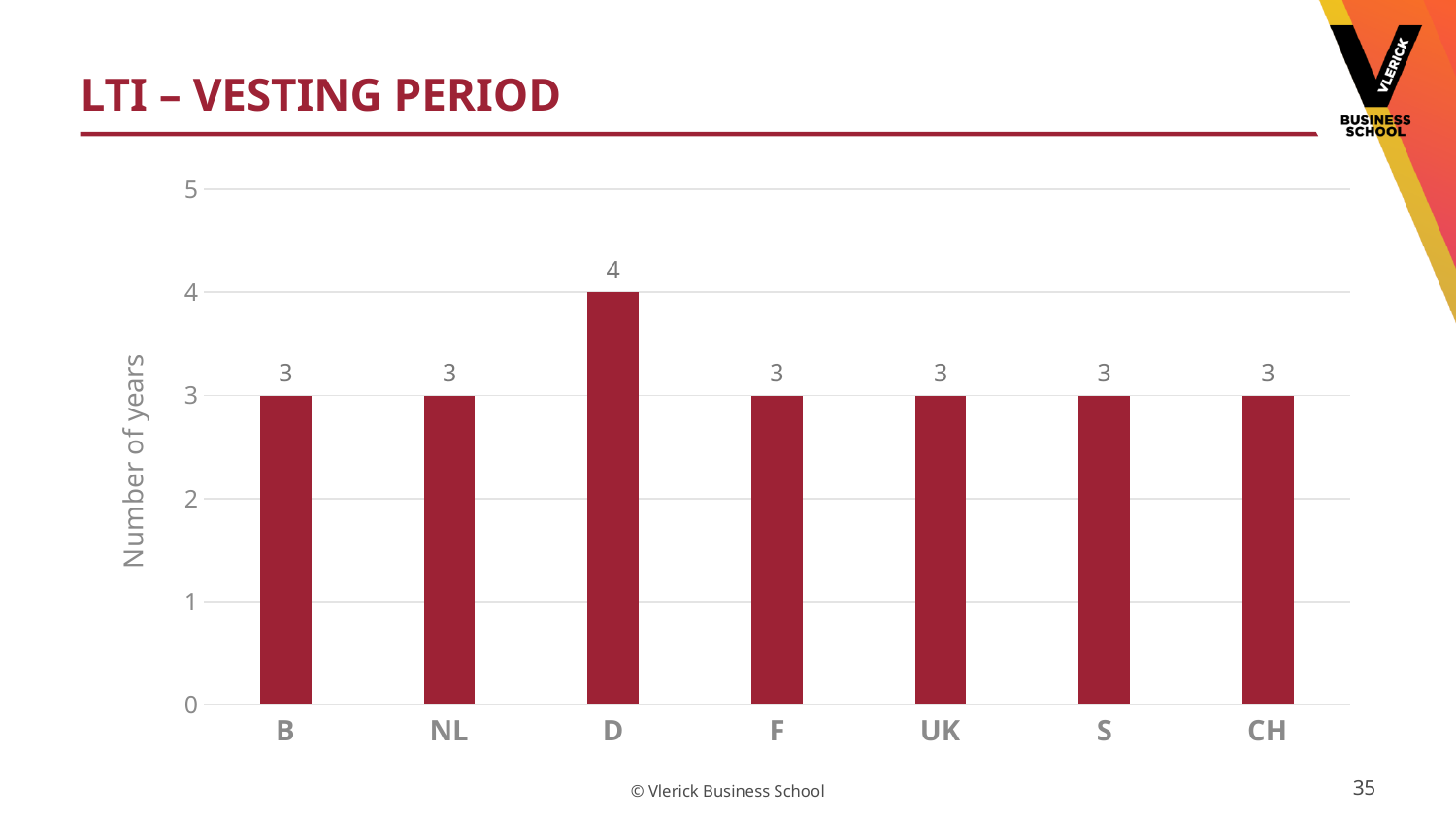
What is the label of the y axis? Number of years Which is larger, the value for D or the value for F? D Is the value for D greater or less than 5? less What kind of chart is shown on the slide? bar chart What is the value for D? 4 What is the value for UK? 3 How many categories have a value of 3? 6 What is the difference between the values for D and B? 1 Which category has the highest value? D What is the value for CH? 3 What is the title of the slide? LTI – VESTING PERIOD How many categories are shown on the x axis? 7